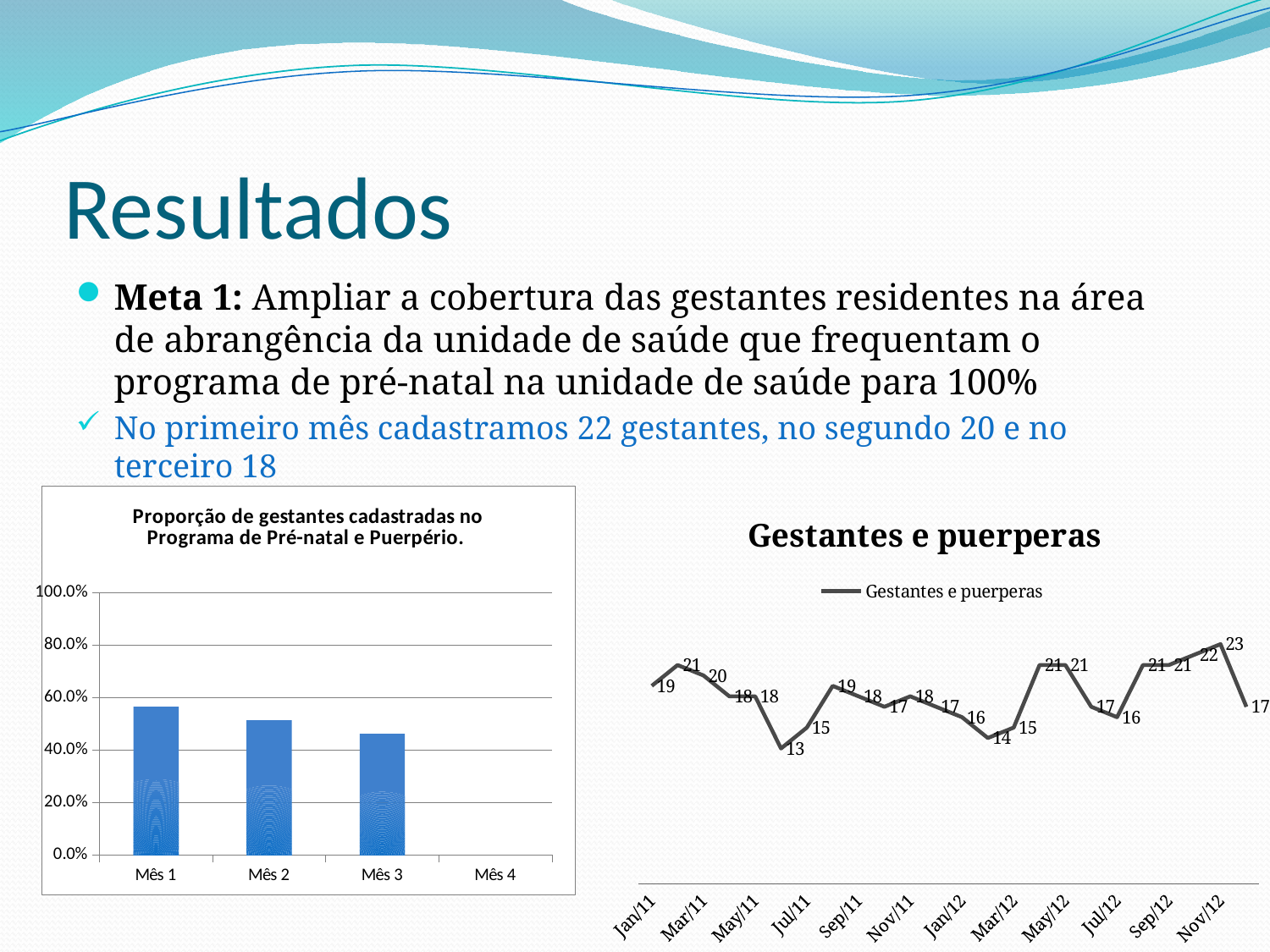
In the bar chart on the left, is the value for Mês 1 greater or less than 40.0%? greater In the chart titled "Gestantes e puerperas", what is the lowest value plotted? 13 In the bar chart on the left, do the values rise or fall from Mês 1 to Mês 3? fall In the bar chart on the left, is the value for Mês 3 greater or less than 60.0%? less How many series does the legend of the chart titled "Gestantes e puerperas" list? 1 What kind of chart is the chart titled "Proporção de gestantes cadastradas no Programa de Pré-natal e Puerpério."? bar chart In the bar chart on the left, which is larger, the value for Mês 1 or the value for Mês 3? Mês 1 What kind of chart is the chart titled "Gestantes e puerperas"? line chart In the bar chart on the left, which month has the highest bar? Mês 1 In the chart titled "Gestantes e puerperas", what is the value for Jan/11? 19 In the chart titled "Gestantes e puerperas", what is the highest value plotted? 23 How many categories are shown on the x axis of the bar chart on the left? 4